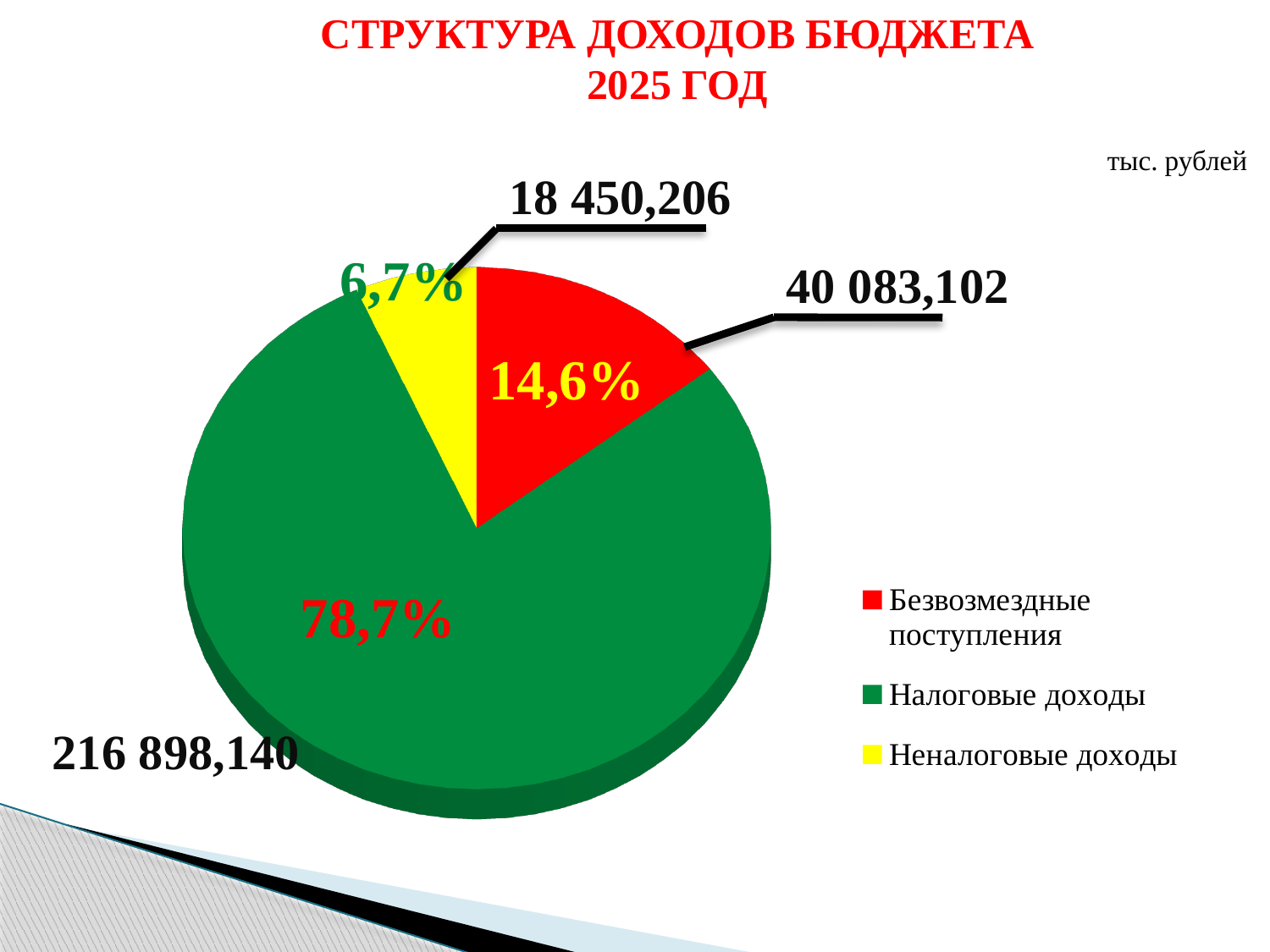
Which category has the smallest slice of the pie? Неналоговые доходы How many categories does the legend list? 3 What share of the pie does Неналоговые доходы have? 6,7% What type of chart is shown on the slide? pie chart What is the value for Налоговые доходы? 216 898,140 Which category has the largest slice of the pie? Налоговые доходы What is the value for Безвозмездные поступления? 40 083,102 What is the difference in percentage points between Налоговые доходы and Безвозмездные поступления? 64,1 What share of the pie does Налоговые доходы have? 78,7% What is the value for Неналоговые доходы? 18 450,206 Which is larger, Безвозмездные поступления or Неналоговые доходы? Безвозмездные поступления What share of the pie does Безвозмездные поступления have? 14,6%